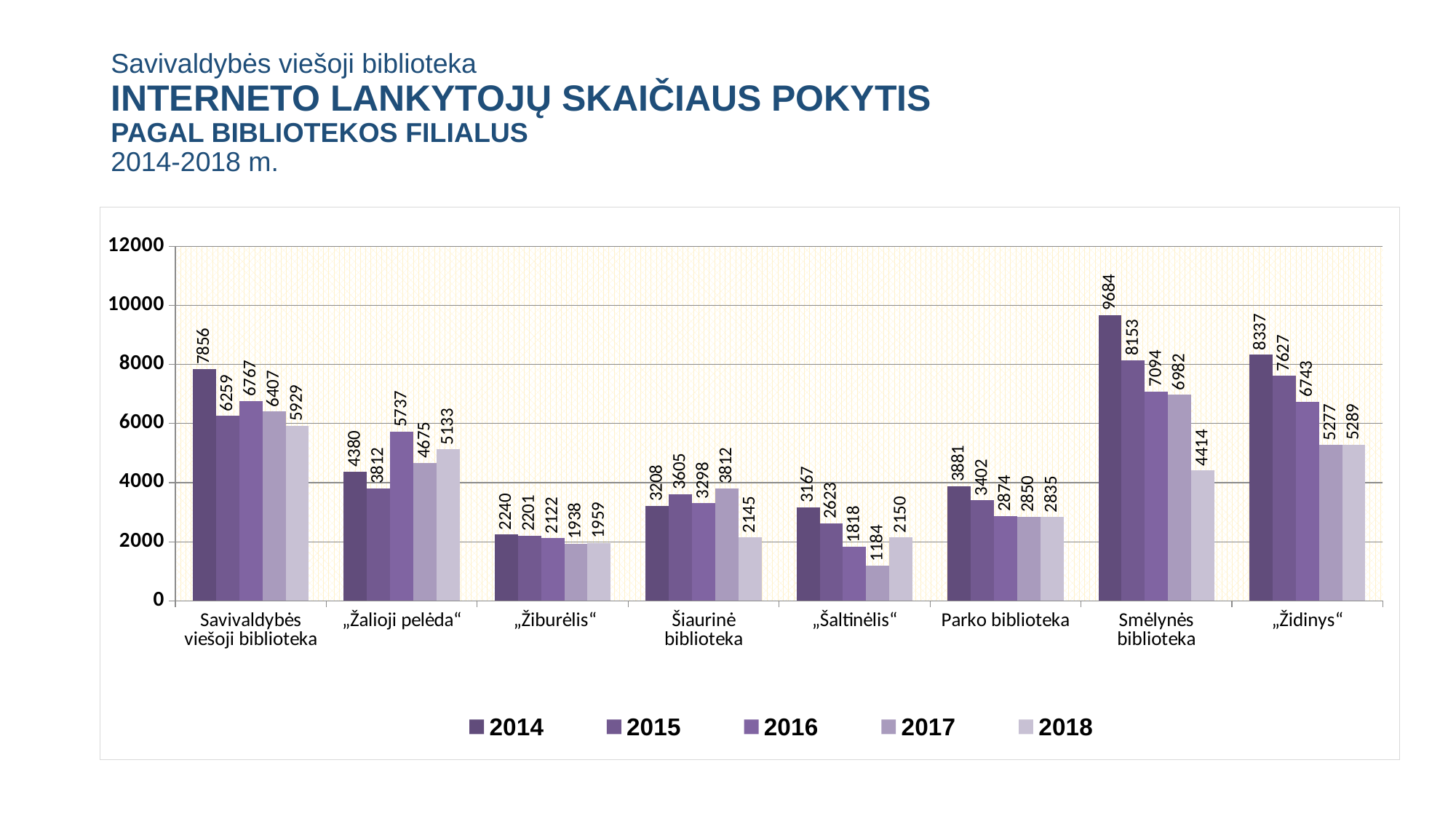
Is the 2014 value for Parko biblioteka greater or less than 4000? less How many series does the legend list? 5 Which library has the lowest value in 2017? „Šaltinėlis“ What is the value for Smėlynės biblioteka in 2014? 9684 What kind of chart is shown on the slide? bar chart What is the value for „Šaltinėlis“ in 2018? 2150 Which library has the highest value in 2014? Smėlynės biblioteka What is the difference between the 2014 and 2018 values for Smėlynės biblioteka? 5270 Which is larger: the 2014 value for „Židinys“ or the 2015 value for Smėlynės biblioteka? 2014 value for „Židinys“ Do the values for Parko biblioteka rise or fall from 2014 to 2018? fall How many libraries (categories) are shown on the x axis? 8 Which years are listed in the chart legend? 2014, 2015, 2016, 2017, 2018